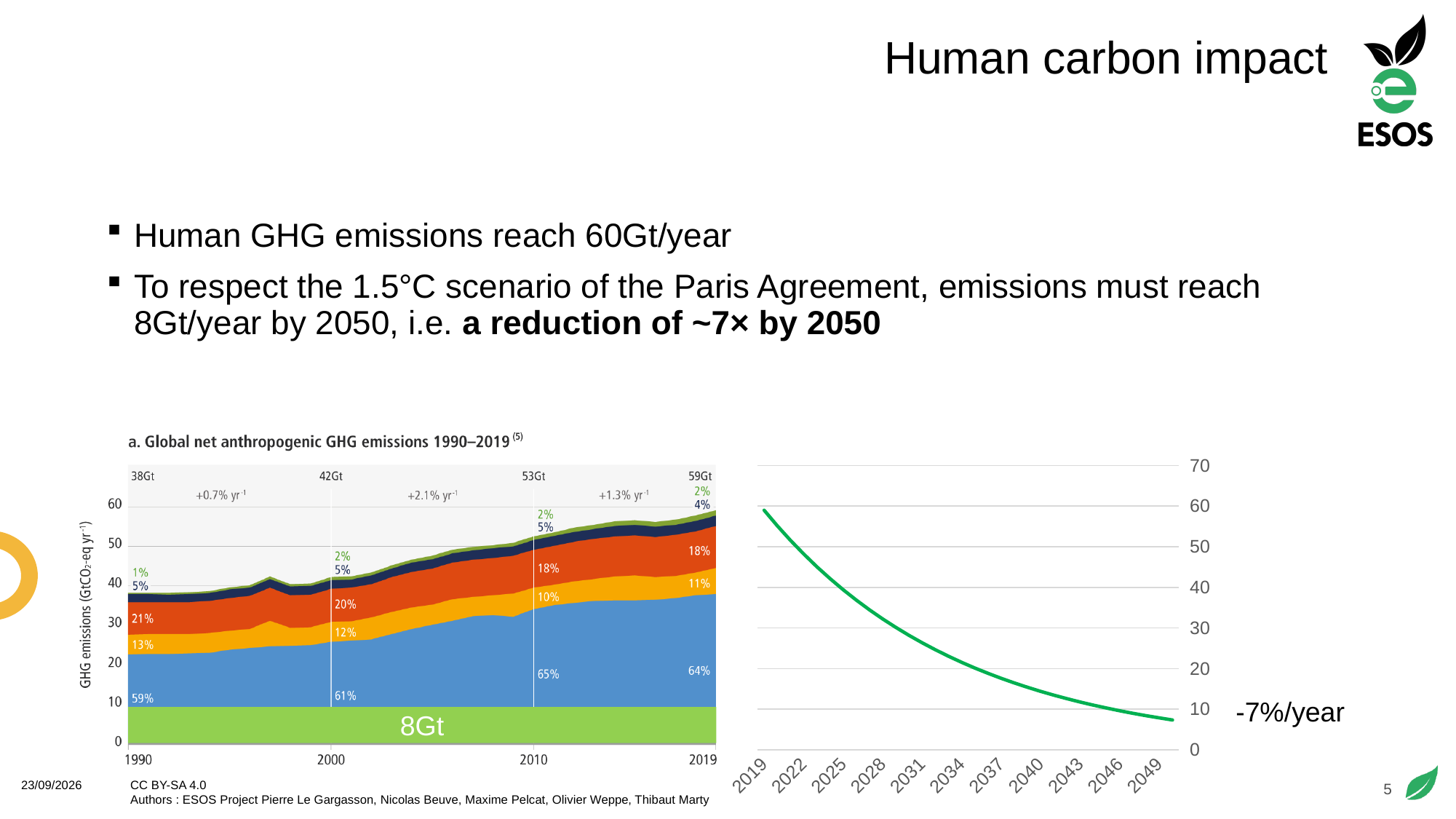
On the left chart, which labelled year has the highest total emissions? 2019 On the right chart, does the line rise or fall from 2019 to 2049? fall On the left chart, do total emissions rise or fall from 1990 to 2019? rise On the left chart, what was the total GHG emissions in 2019? 59Gt On the right chart, is the value for 2019 greater or less than 50? greater On the left chart, what annual growth rate is shown for the period 2000 to 2010? +2.1% yr⁻¹ On the left chart, what was the total global net anthropogenic GHG emissions in 1990? 38Gt What kind of chart is the right chart? line chart On the left chart, what share of emissions does the blue (bottom) category represent in 2010? 65% On the left chart, by how much did total emissions increase between 1990 and 2019? 21Gt On the left chart, which labelled year has the lowest total emissions? 1990 What kind of chart is the left chart? stacked area chart